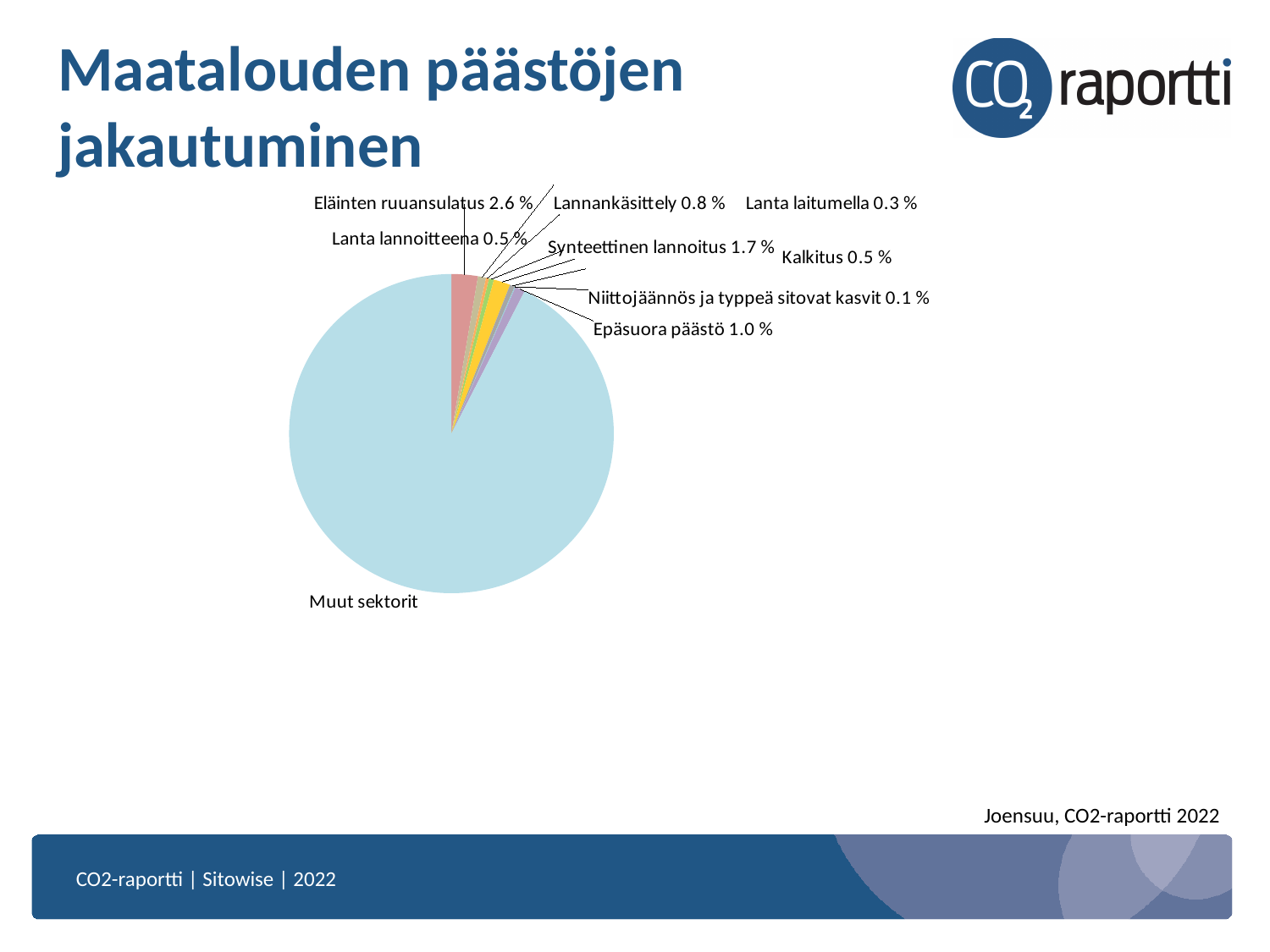
What share is shown for Lanta laitumella? 0.3 % What is the title of the slide containing the chart? Maatalouden päästöjen jakautuminen What share is shown for Synteettinen lannoitus? 1.7 % Which is larger, the share of Lannankäsittely or the share of Epäsuora päästö? Epäsuora päästö What kind of chart is shown on the slide? pie chart What share of emissions does Eläinten ruuansulatus account for? 2.6 % What share is shown for Niittojäännös ja typpeä sitovat kasvit? 0.1 % Among the slices with a printed percentage, which has the smallest share? Niittojäännös ja typpeä sitovat kasvit What share is shown for Epäsuora päästö? 1.0 % What is the difference between the shares of Eläinten ruuansulatus and Synteettinen lannoitus? 0.9 % Which slice of the pie is the largest? Muut sektorit How many slices does the pie chart have? 9